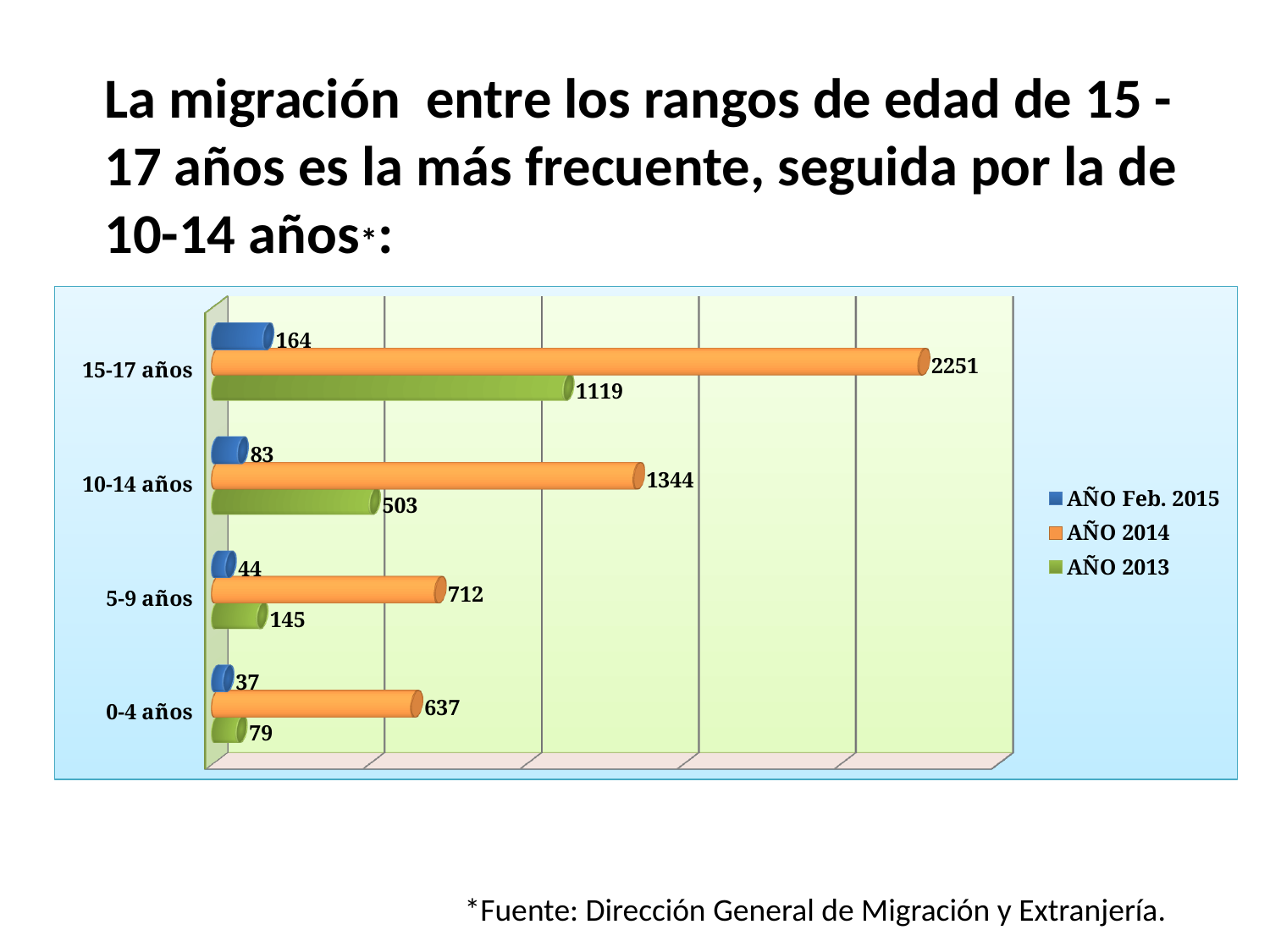
What is the value for AÑO Feb. 2015 in the 0-4 años category? 37 What is the total of the three series values for the 5-9 años category? 901 Which series is shown in orange in the legend? AÑO 2014 Which is larger: the AÑO 2013 value for 5-9 años or the AÑO Feb. 2015 value for 15-17 años? AÑO Feb. 2015 value for 15-17 años Which age category has the highest value for AÑO 2014? 15-17 años What is the value for AÑO 2014 in the 15-17 años category? 2251 How many age categories are shown in the chart? 4 What kind of chart is shown on the slide? Bar chart What is the value for AÑO 2013 in the 10-14 años category? 503 What is the difference between the AÑO 2014 values for 15-17 años and 10-14 años? 907 How many series does the legend list? 3 Which age category has the lowest value for AÑO 2013? 0-4 años